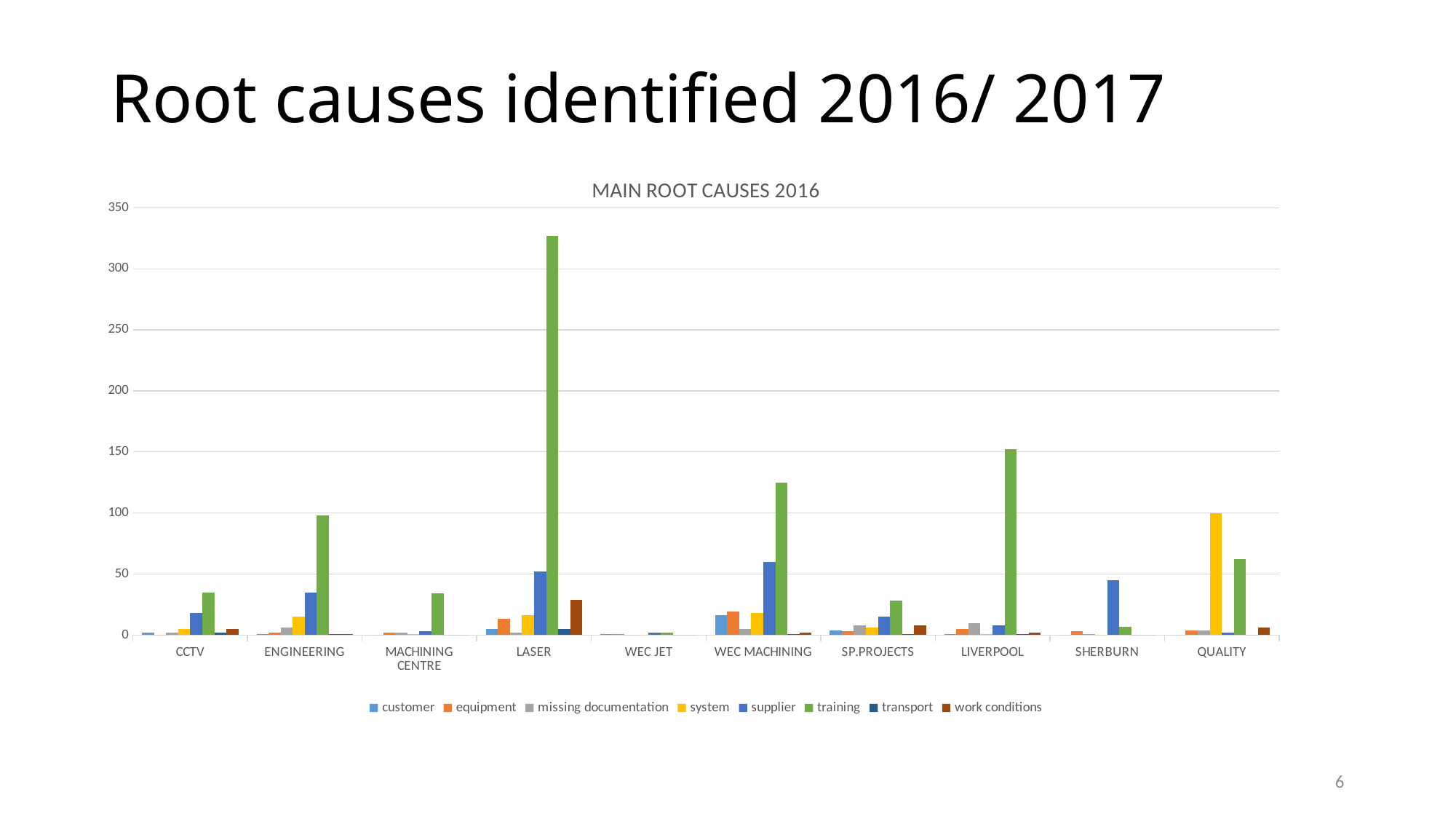
What colour represents the training series in the legend? Green Is the supplier value for WEC MACHINING greater or less than 50? greater Is the training value for LASER greater or less than 300? greater What type of chart is shown on the slide? Bar chart Which category has the highest training value? LASER For QUALITY, which is larger, the system value or the training value? system How many categories are shown on the x axis? 10 What is the title of the chart? MAIN ROOT CAUSES 2016 Is the training value for WEC MACHINING greater or less than 100? greater Which is larger, the training value for LASER or the training value for LIVERPOOL? LASER How many series does the legend list? 8